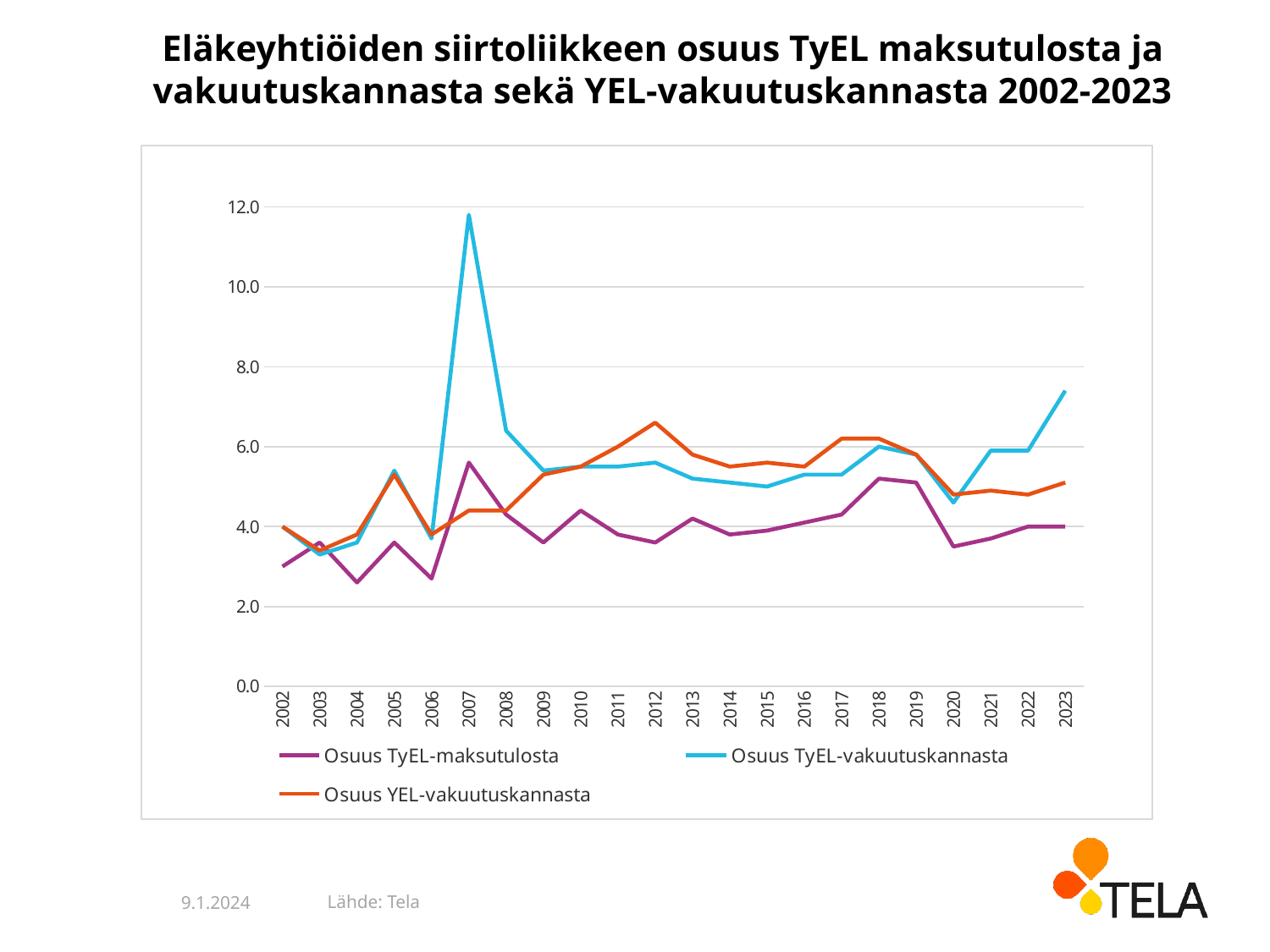
Does the Osuus TyEL-vakuutuskannasta series rise or fall from 2020 to 2023? rise Which series is drawn in light blue? Osuus TyEL-vakuutuskannasta In which year does the Osuus YEL-vakuutuskannasta series reach its highest value? 2012 Is the value for Osuus TyEL-vakuutuskannasta in 2007 greater or less than 10.0? greater In 2012, which series has the larger value: Osuus YEL-vakuutuskannasta or Osuus TyEL-maksutulosta? Osuus YEL-vakuutuskannasta Is the value for Osuus TyEL-maksutulosta in 2004 greater or less than 4.0? less In which year does the Osuus TyEL-vakuutuskannasta series reach its highest value? 2007 What kind of chart is shown on the slide? line chart Is the value for Osuus TyEL-vakuutuskannasta in 2023 greater or less than 6.0? greater How many years are plotted along the x axis? 22 How many series does the legend list? 3